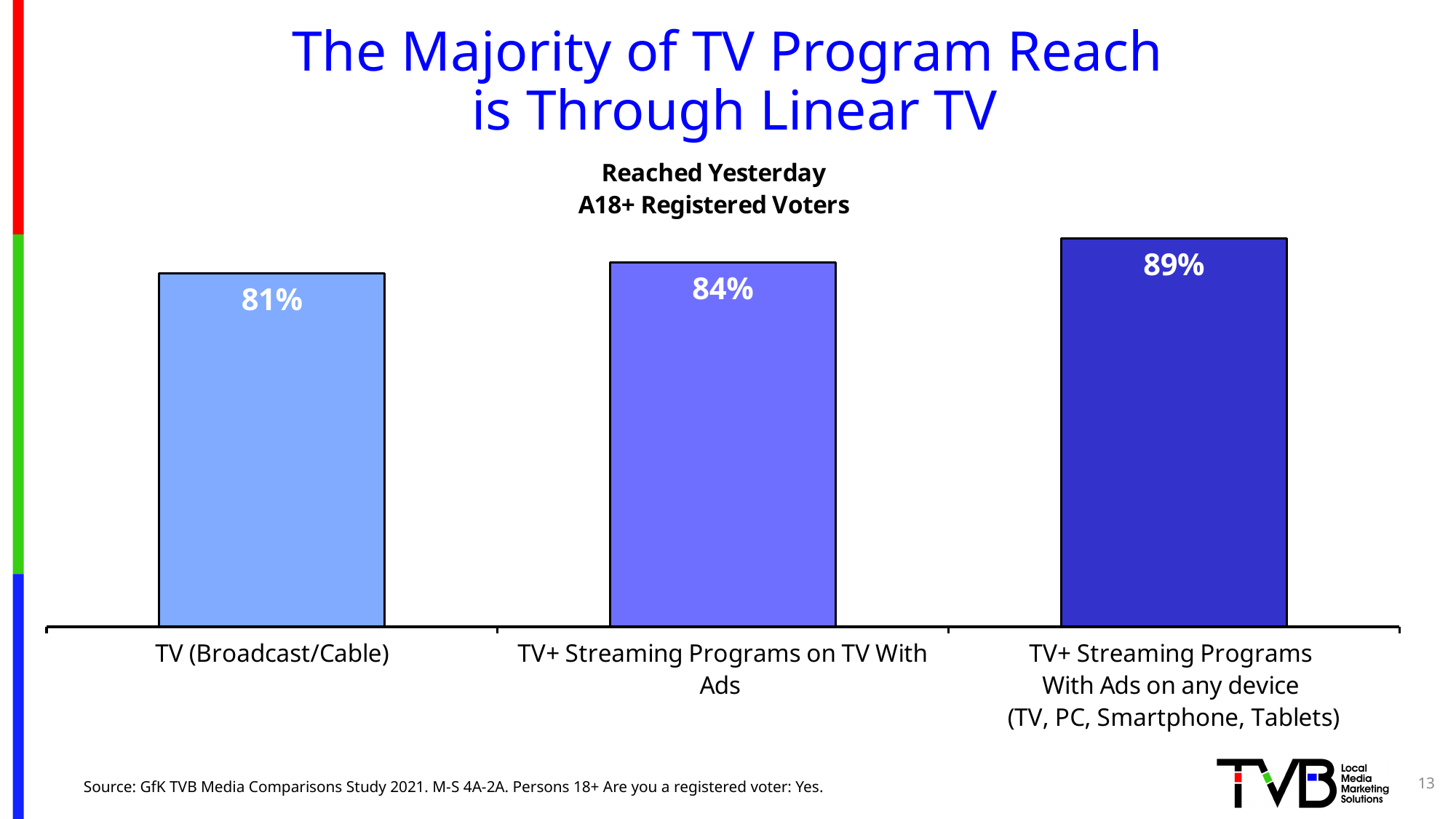
What is the value for TV (Broadcast/Cable)? 81% Which category has the lowest value? TV (Broadcast/Cable) What is the value for TV+ Streaming Programs on TV With Ads? 84% How many categories are shown in the chart? 3 What is the difference between the value for TV+ Streaming Programs With Ads on any device and the value for TV (Broadcast/Cable)? 8% What is the difference between the value for TV+ Streaming Programs on TV With Ads and the value for TV (Broadcast/Cable)? 3% Which category has the highest value? TV+ Streaming Programs With Ads on any device (TV, PC, Smartphone, Tablets) Do the values rise or fall from left to right across the categories? Rise What is the title of the chart? Reached Yesterday A18+ Registered Voters Which is larger: the value for TV (Broadcast/Cable) or the value for TV+ Streaming Programs on TV With Ads? TV+ Streaming Programs on TV With Ads What kind of chart is shown on the slide? Bar chart What is the value for TV+ Streaming Programs With Ads on any device (TV, PC, Smartphone, Tablets)? 89%